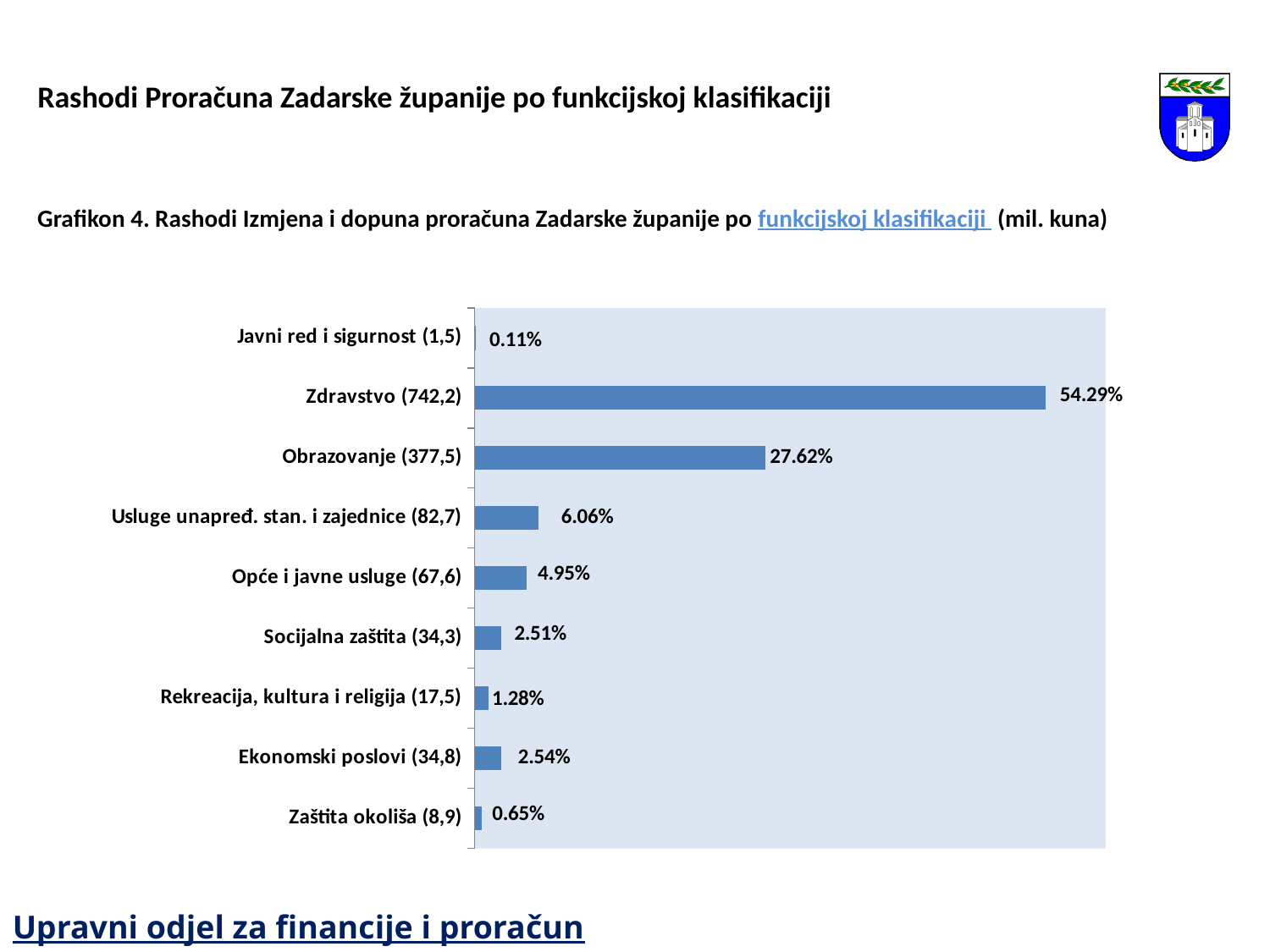
What is the difference in percentage points between Usluge unapređ. stan. i zajednice and Opće i javne usluge? 1.11% What percentage is shown for Obrazovanje? 27.62% What is the difference in percentage points between Zdravstvo and Obrazovanje? 26.67% How many categories are shown in the chart? 9 Which category has the lowest percentage? Javni red i sigurnost Which has a larger percentage, Socijalna zaštita or Rekreacija, kultura i religija? Socijalna zaštita What unit is stated in the chart caption for the values in parentheses? mil. kuna What percentage is shown for Zaštita okoliša? 0.65% What percentage is shown for Usluge unapređ. stan. i zajednice? 6.06% Which category has the highest percentage? Zdravstvo What kind of chart is shown on the slide? bar chart What percentage is shown for Zdravstvo? 54.29%